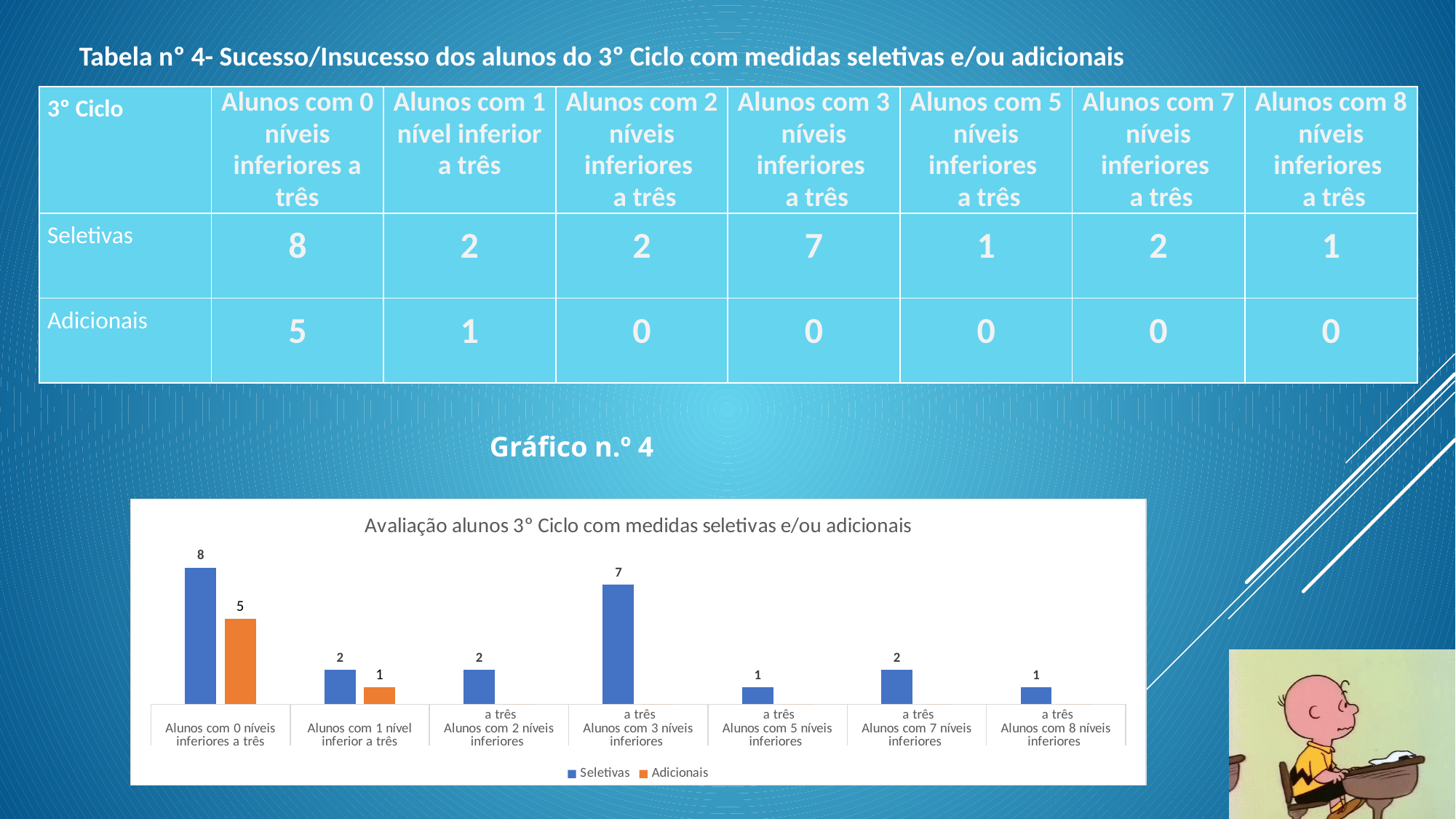
What is the value for Adicionais in the category 'Alunos com 1 nível inferior a três'? 1 Which is larger: the Seletivas value for 'Alunos com 3 níveis inferiores a três' or the Seletivas value for 'Alunos com 7 níveis inferiores a três'? Alunos com 3 níveis inferiores a três What is the difference between the Seletivas and Adicionais values for 'Alunos com 0 níveis inferiores a três'? 3 What kind of chart is shown on the slide? Bar chart What is the title of the chart? Avaliação alunos 3° Ciclo com medidas seletivas e/ou adicionais How many series does the chart legend list? 2 How many categories are shown on the x axis of the chart? 7 What is the value for Seletivas in the category 'Alunos com 0 níveis inferiores a três'? 8 What is the value for Seletivas in the category 'Alunos com 3 níveis inferiores a três'? 7 Which category has the highest value for Seletivas? Alunos com 0 níveis inferiores a três Which colour represents the Adicionais series in the chart? Orange What is the value for Adicionais in the category 'Alunos com 0 níveis inferiores a três'? 5